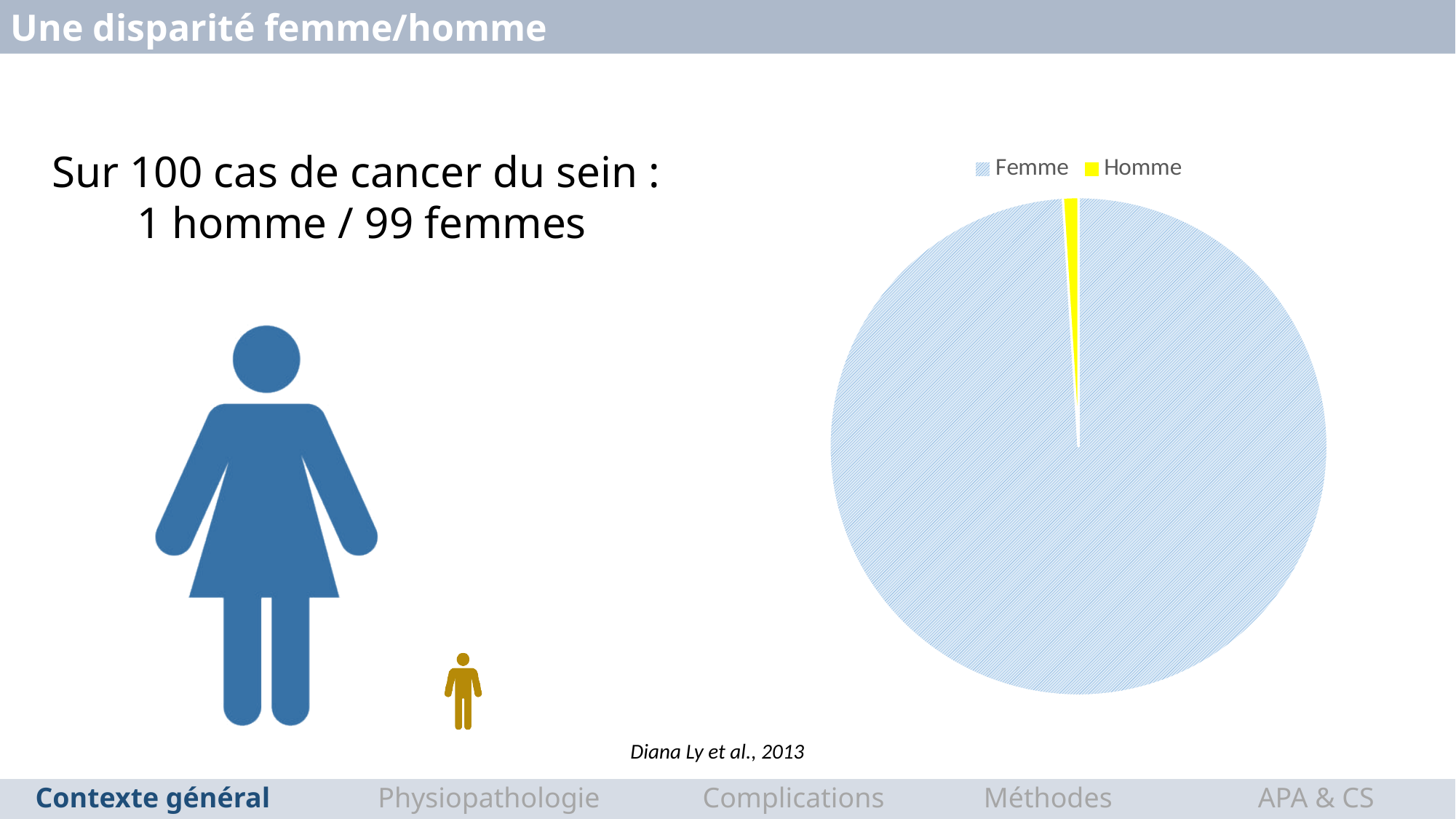
What share of the pie chart does the Femme slice represent, based on the figures stated on the slide? 99% According to the slide, out of 100 breast cancer cases, how many are women? 99 What share of the pie chart does the Homme slice represent, based on the figures stated on the slide? 1% Which slice is larger in the pie chart, Femme or Homme? Femme Which category has the largest slice in the pie chart? Femme What colour is the Homme slice in the pie chart? yellow According to the slide, out of 100 breast cancer cases, how many are men? 1 What are the two legend entries of the pie chart? Femme, Homme How many entries does the legend of the pie chart list? 2 Which category has the smallest slice in the pie chart? Homme What kind of chart is shown on the slide? pie chart How many slices does the pie chart have? 2